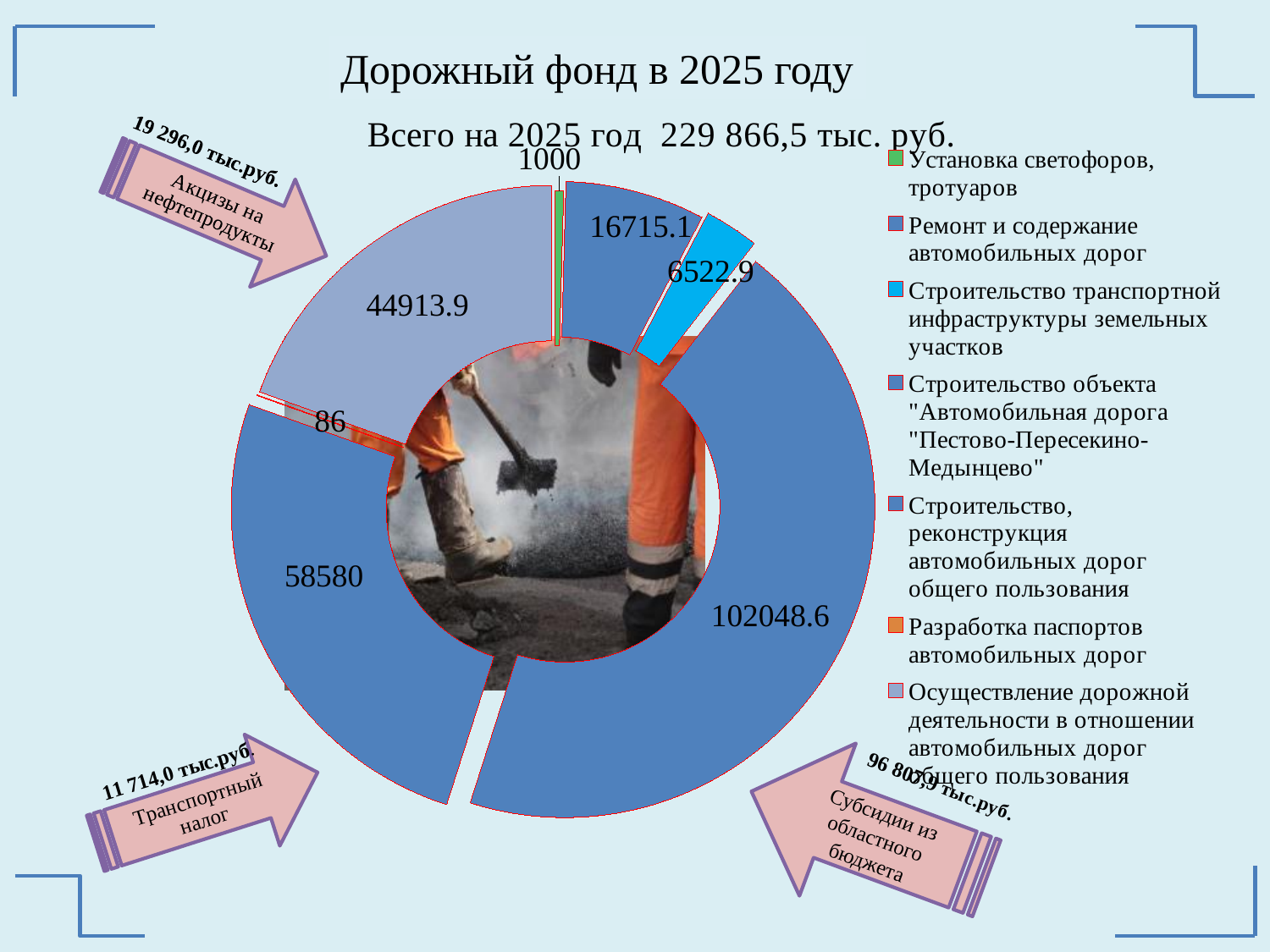
What is the title of the slide's chart? Всего на 2025 год 229 866,5 тыс. руб. Which category has the smallest value in the chart? Разработка паспортов автомобильных дорог What kind of chart is shown on the slide? Doughnut (pie) chart What is the value shown for Строительство транспортной инфраструктуры земельных участков? 6522.9 What is the value shown for the largest segment of the chart? 102048.6 What is the value shown for Установка светофоров, тротуаров? 1000 What is the difference between the segment labelled 102048.6 and the segment labelled 58580? 43468.6 How many categories does the legend of the chart list? 7 What is the value shown for Осуществление дорожной деятельности в отношении автомобильных дорог общего пользования? 44913.9 Which is larger: the segment for Ремонт и содержание автомобильных дорог (16715.1) or the segment for Строительство транспортной инфраструктуры земельных участков (6522.9)? Ремонт и содержание автомобильных дорог Which category has the largest value in the chart? Строительство объекта "Автомобильная дорога "Пестово-Пересекино-Медынцево" What total amount for 2025 is stated above the chart? 229 866,5 тыс. руб.